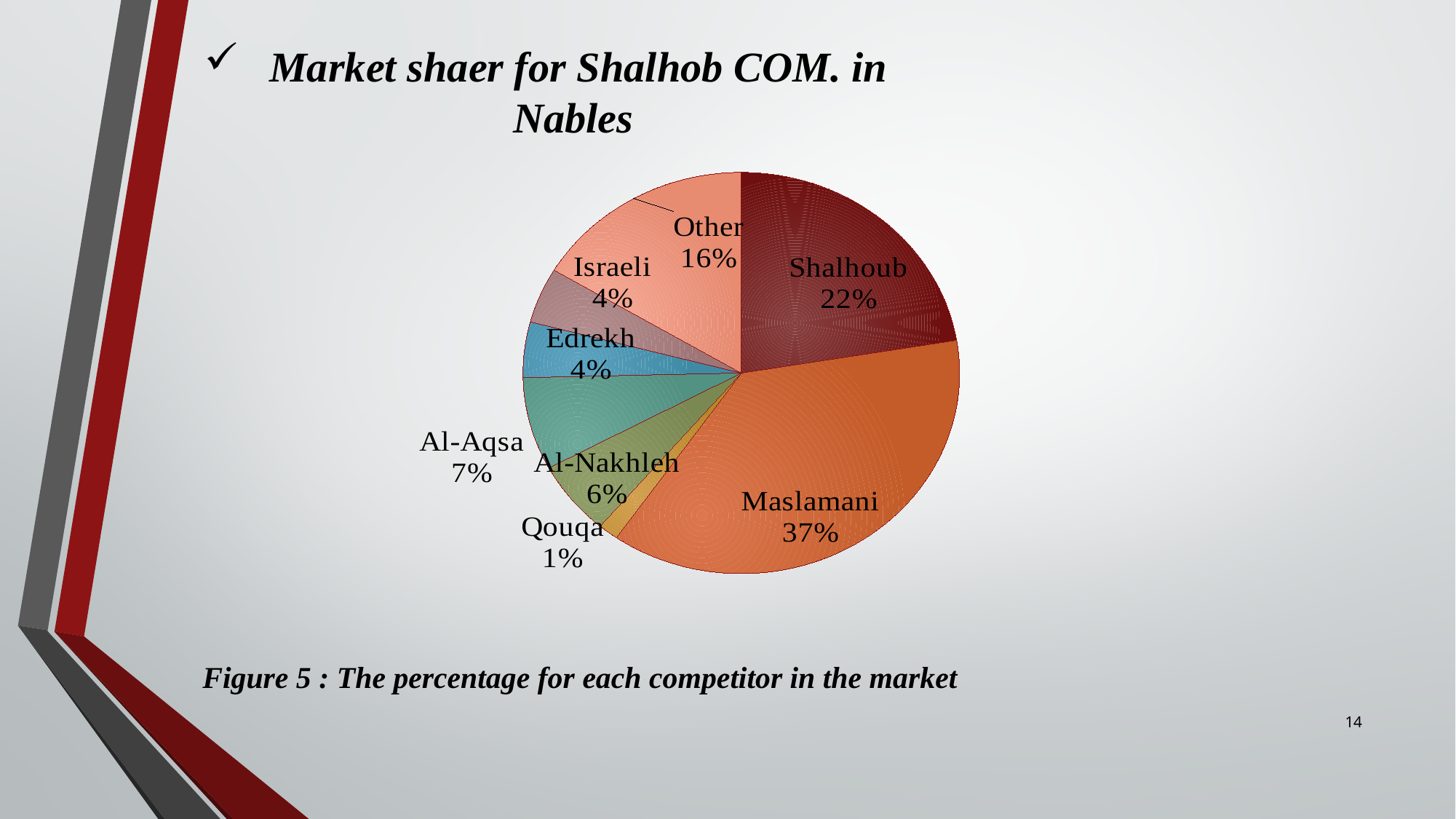
What is the market share for Al-Aqsa? 7% What is the market share for Maslamani? 37% Which competitor has the largest share of the pie? Maslamani Which has a larger share, Al-Aqsa or Al-Nakhleh? Al-Aqsa What is the market share for Shalhoub? 22% What is the market share for Qouqa? 1% What kind of chart is shown on the slide? pie chart What is the figure caption below the chart? Figure 5 : The percentage for each competitor in the market What is the market share for Other? 16% How many slices does the pie chart have? 8 Which competitor has the smallest share of the pie? Qouqa What is the difference between the shares of Maslamani and Shalhoub? 15%